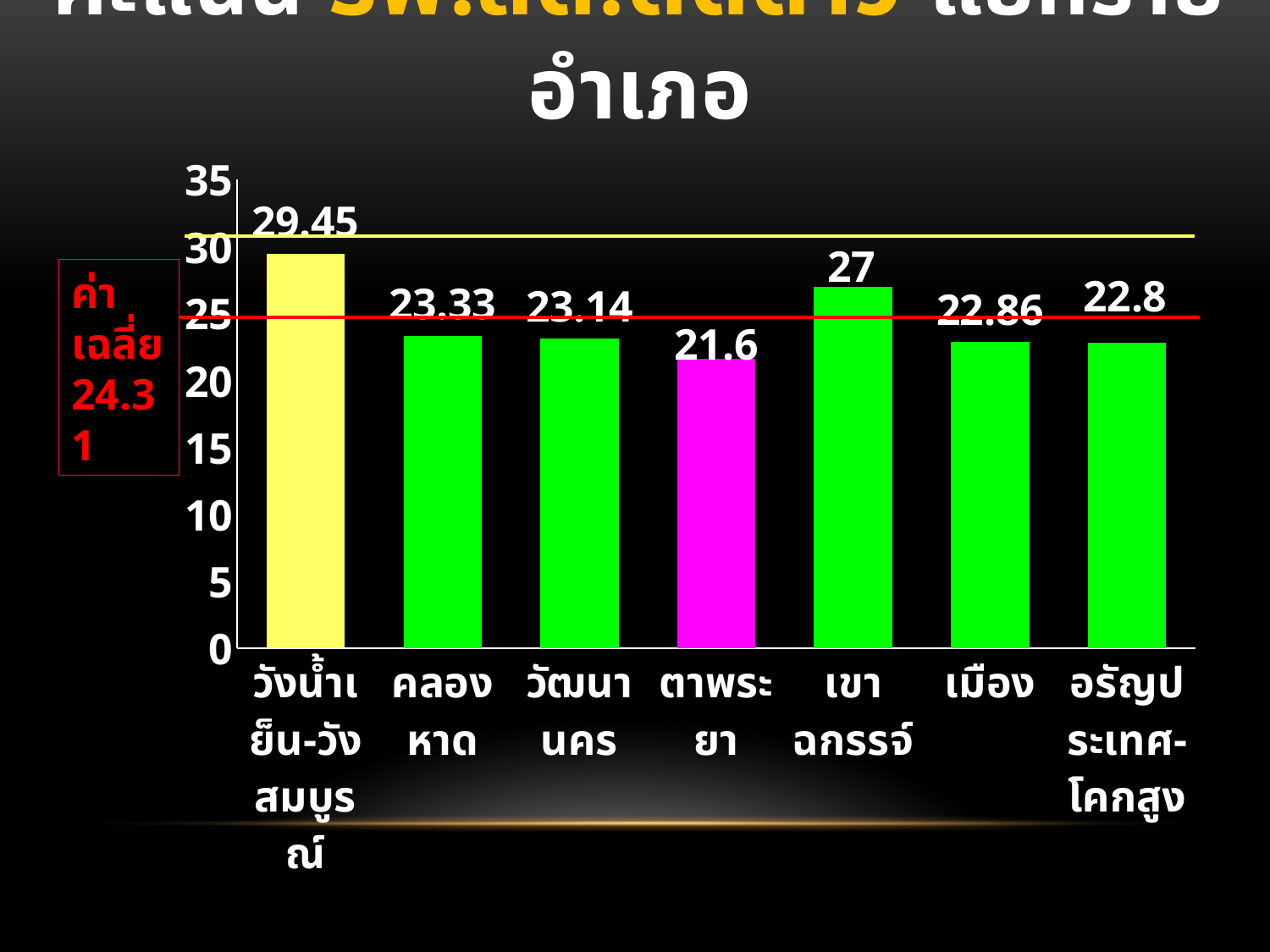
What is the value for เขาฉกรรจ์? 27 Which is larger, the value for คลองหาด or the value for อรัญประเทศ-โคกสูง? คลองหาด What kind of chart is shown on the slide? bar chart What is the value for เมือง? 22.86 What is the difference between the values for วังน้ำเย็น-วังสมบูรณ์ and ตาพระยา? 7.85 What average value (ค่าเฉลี่ย) is shown in the red text box on the slide? 24.31 Is the value for เขาฉกรรจ์ greater or less than 25? greater How many categories are shown on the x axis? 7 What is the value for วังน้ำเย็น-วังสมบูรณ์? 29.45 Which category has the highest value? วังน้ำเย็น-วังสมบูรณ์ What is the value for ตาพระยา? 21.6 Which category has the lowest value? ตาพระยา